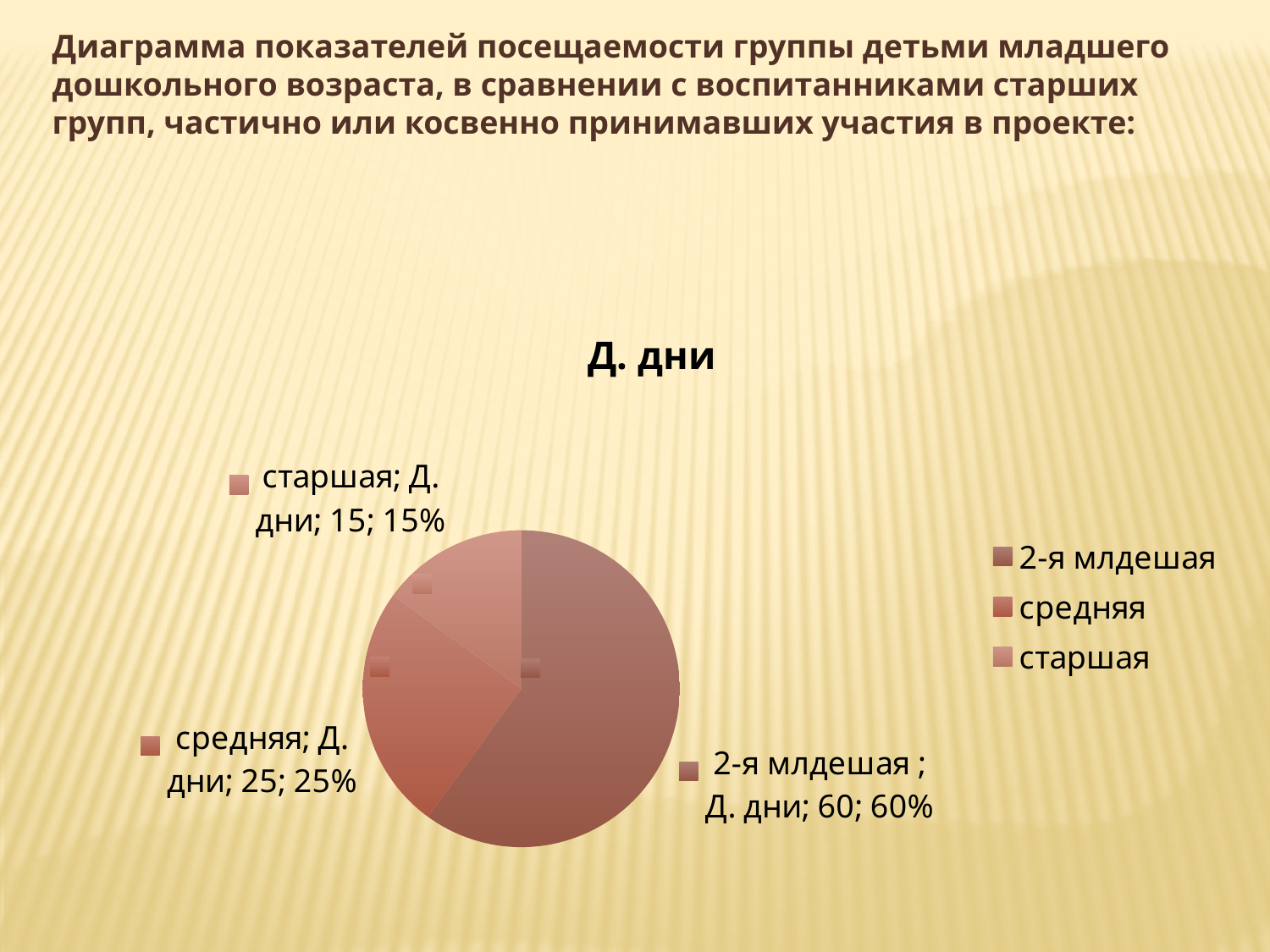
What is the value for старшая? 15 Which is larger, the value for средняя or the value for старшая? средняя Which group has the largest slice? 2-я млдешая What is the value for средняя? 25 How many entries does the legend list? 3 What is the title of the chart? Д. дни What kind of chart is shown on the slide? pie chart What is the value for 2-я млдешая? 60 How many slices does the pie chart have? 3 What share of the pie does средняя take? 25% What is the difference between the values for 2-я млдешая and старшая? 45 Which group has the smallest slice? старшая